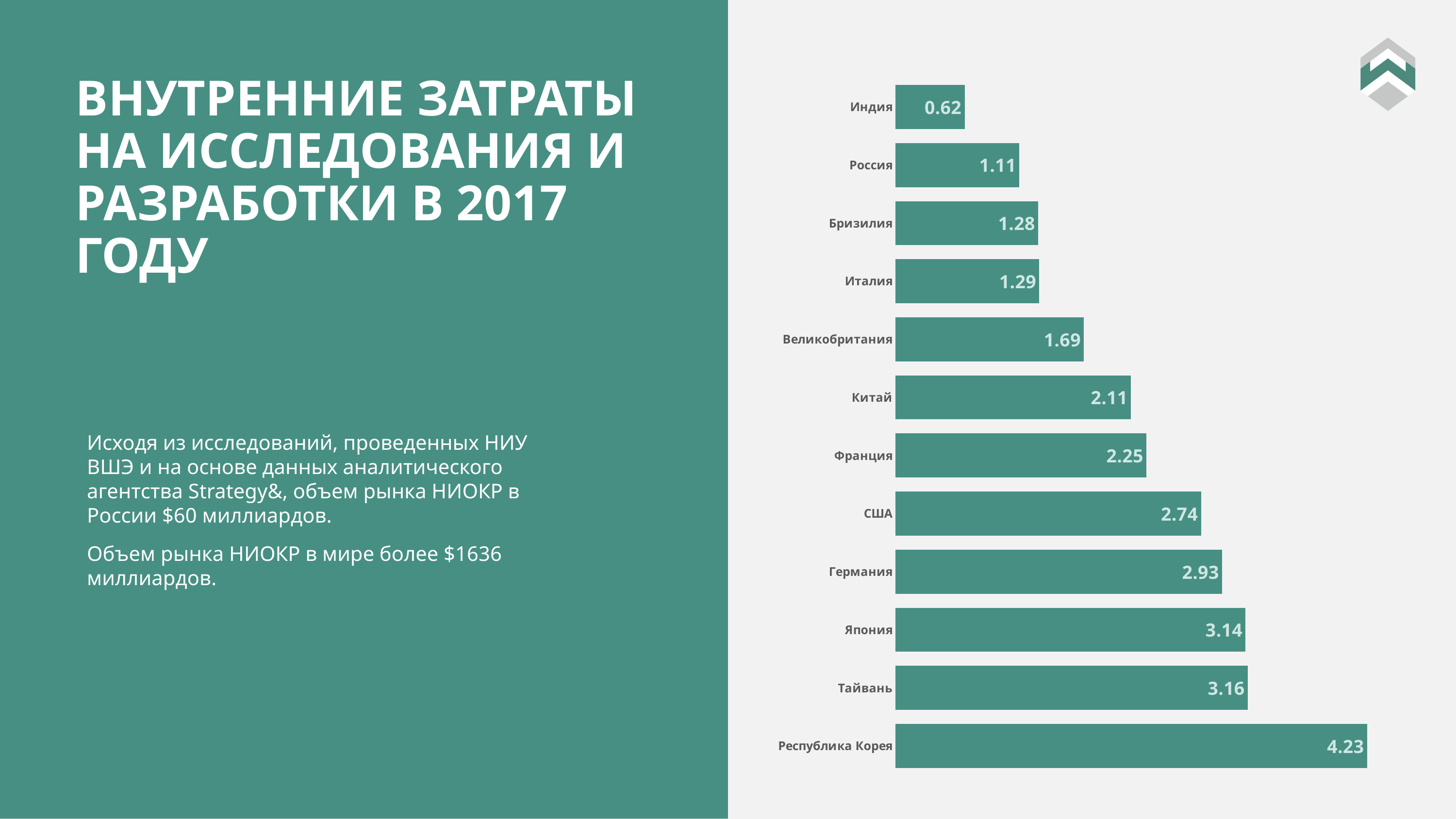
What is the value shown for Китай? 2.11 What is the difference between the values for Республика Корея and Индия? 3.61 Which country has the highest value in the chart? Республика Корея What is the difference between the values for США and Франция? 0.49 Which has a larger value, Германия or США? Германия What is the value shown for Великобритания? 1.69 Which has a larger value, Китай or Великобритания? Китай What is the value shown for Россия? 1.11 What kind of chart is shown on the slide? Bar chart How many countries are shown in the chart? 12 What is the value shown for Германия? 2.93 Which country has the lowest value in the chart? Индия